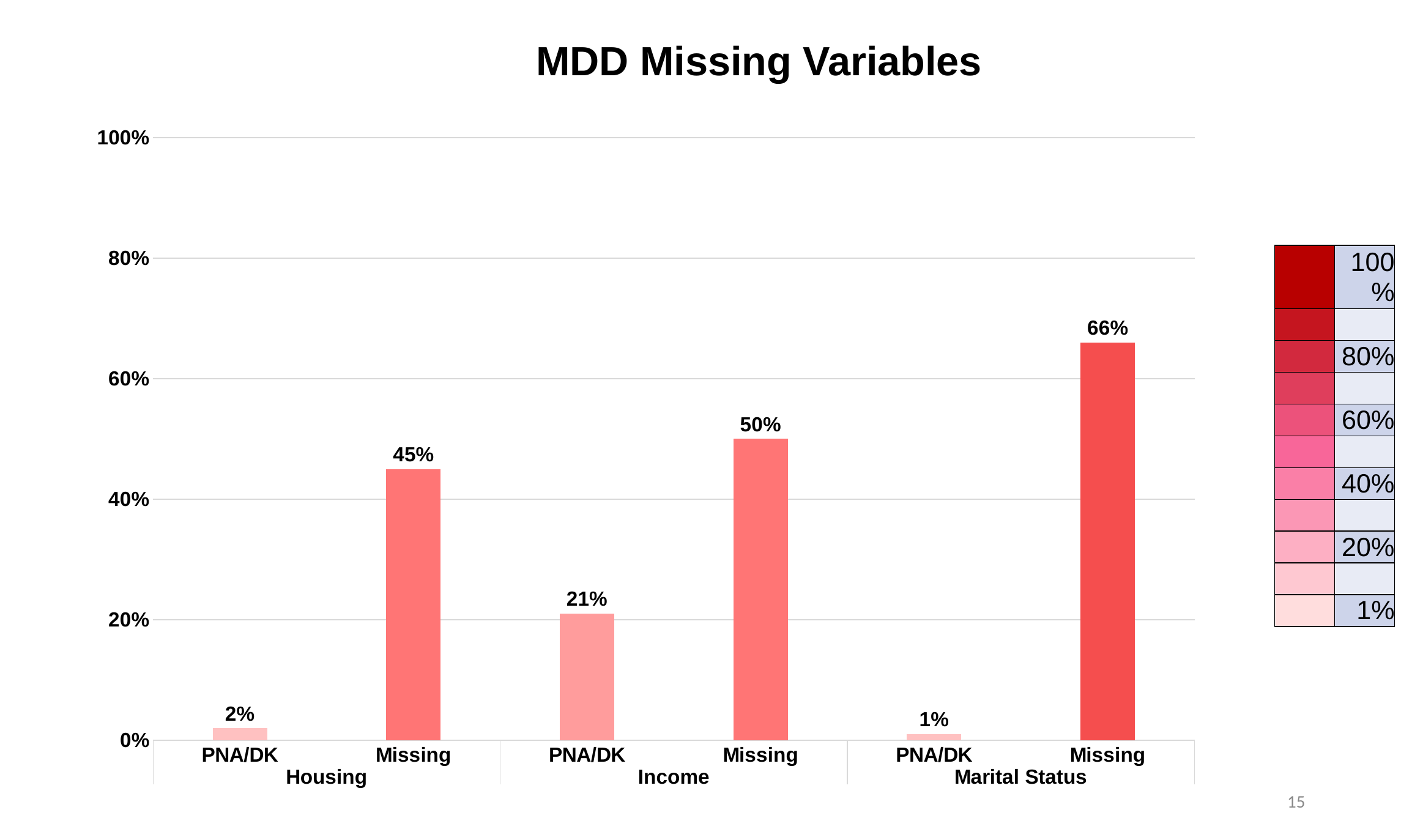
What is the value for PNA/DK under Marital Status? 1% What is the value for PNA/DK under Income? 21% Which is larger, PNA/DK under Income or PNA/DK under Housing? PNA/DK under Income What is the title of the chart? MDD Missing Variables What is the value for Missing under Housing? 45% How many bars are plotted on the chart? 6 Which bar has the lowest value? PNA/DK under Marital Status What is the value for Missing under Marital Status? 66% What is the difference between Missing under Income and Missing under Housing? 5% How many variable groups are shown on the x axis? 3 What kind of chart is shown? Bar chart Which bar has the highest value? Missing under Marital Status